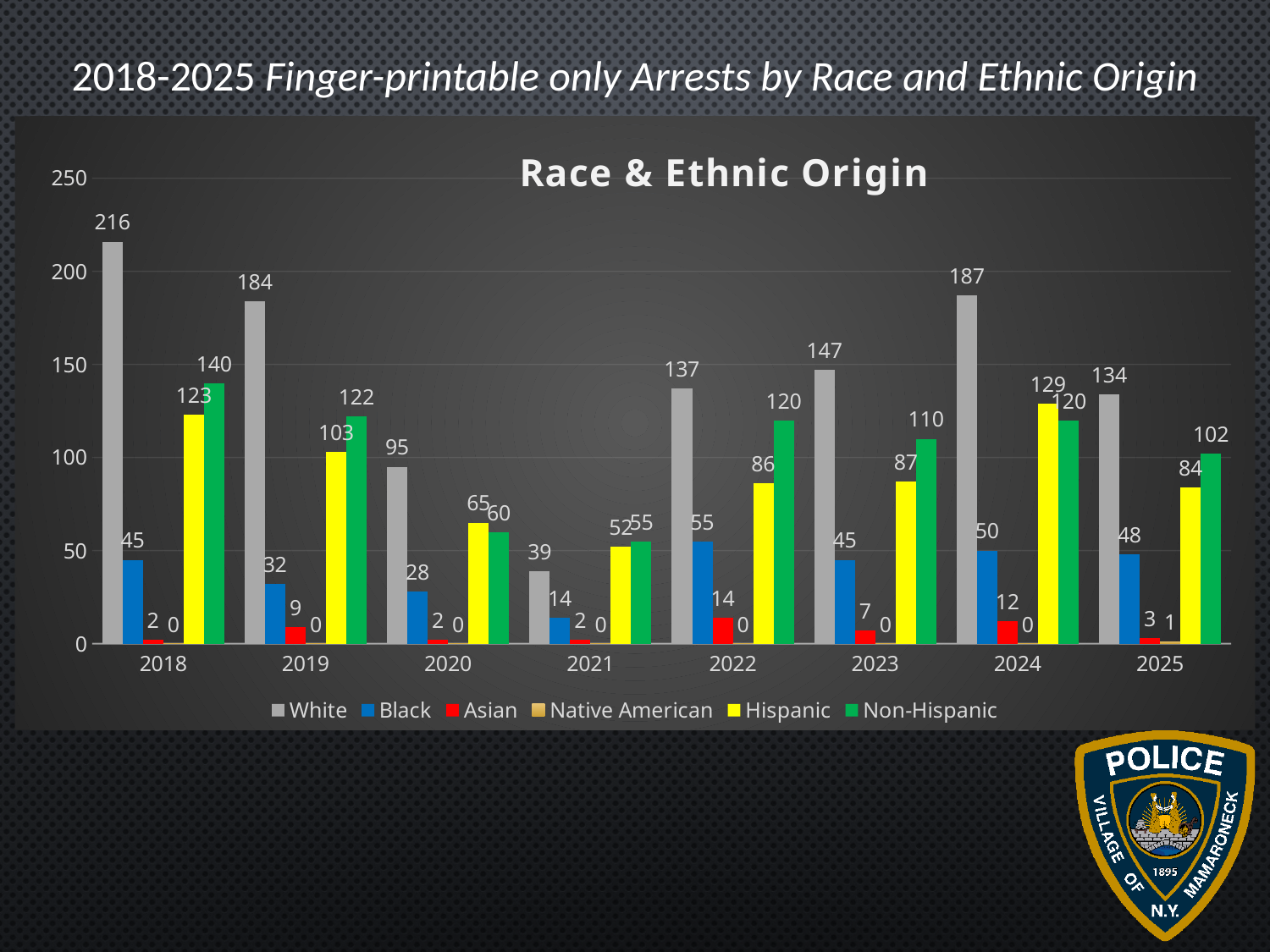
What kind of chart is shown? Bar chart What is the difference between the White values for 2024 and 2025? 53 What is the value for White in 2018? 216 Which year has the lowest value for White? 2021 Which year has the highest value for White? 2018 What is the value for Asian in 2022? 14 Does the White value rise or fall from 2018 to 2021? Fall Which is larger in 2020, Hispanic or Non-Hispanic? Hispanic How many series does the legend list? 6 What is the title of the chart? Race & Ethnic Origin What is the value for Hispanic in 2024? 129 How many years are shown on the x axis? 8